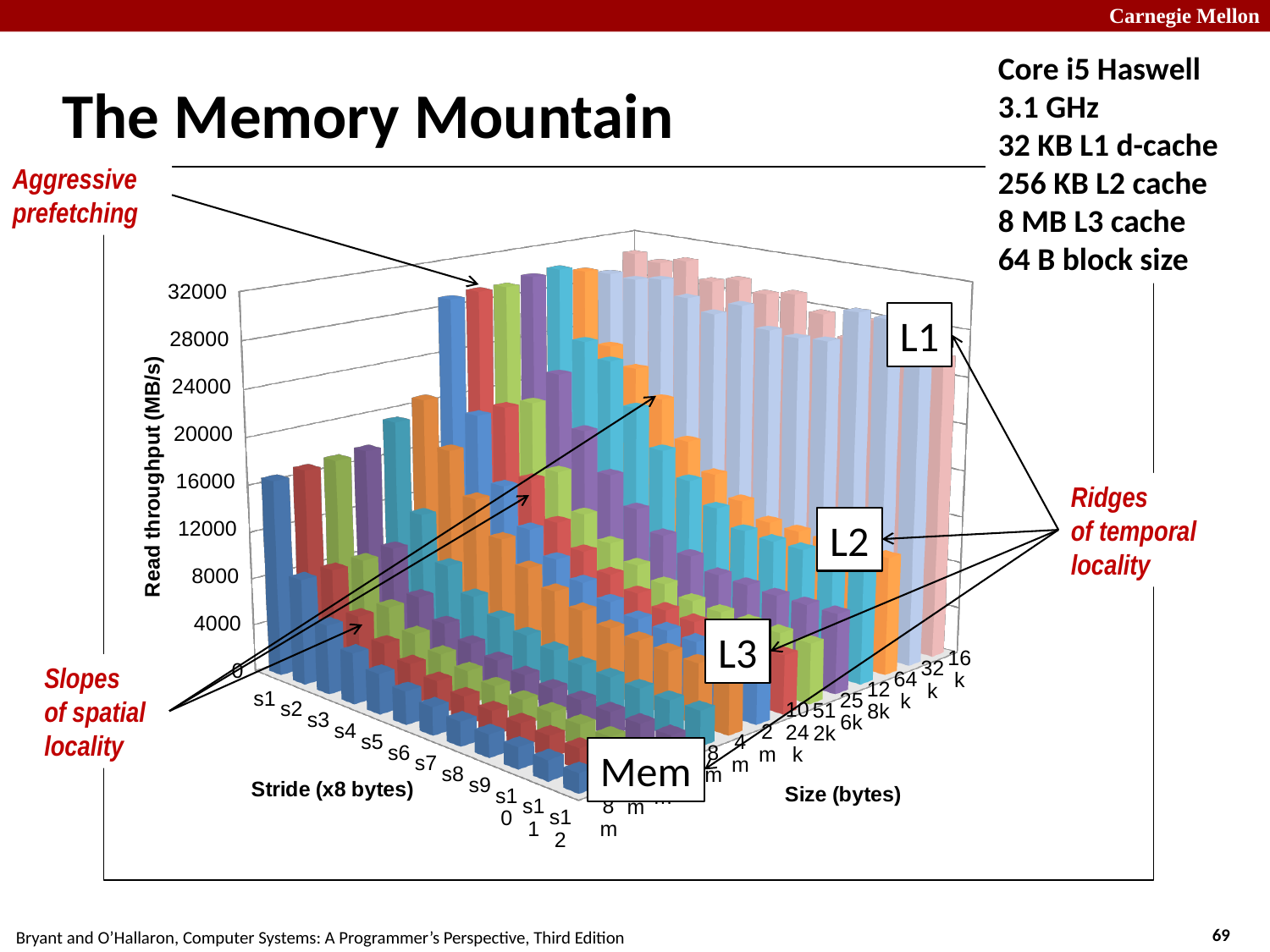
How many stride categories (s1 through s12) are shown along the Stride axis? 12 Are the tallest bars on the L1 ridge at the back of the chart greater or less than 24000 MB/s? greater Is the read throughput for the front-left bar (stride s1, largest size) greater or less than 8000? greater What is the label on the vertical axis of the chart? Read throughput (MB/s) Which region of the chart has higher read throughput: the L1 ridge or the Mem region? L1 ridge What kind of chart is shown on the slide? bar chart Along the front row (largest size), does read throughput rise or fall as the stride increases from s1 to s12? fall What is the title of the slide's chart? The Memory Mountain What is the highest tick value shown on the Read throughput axis? 32000 Is the read throughput for the front-right bar (stride s12, largest size) greater or less than 8000? less